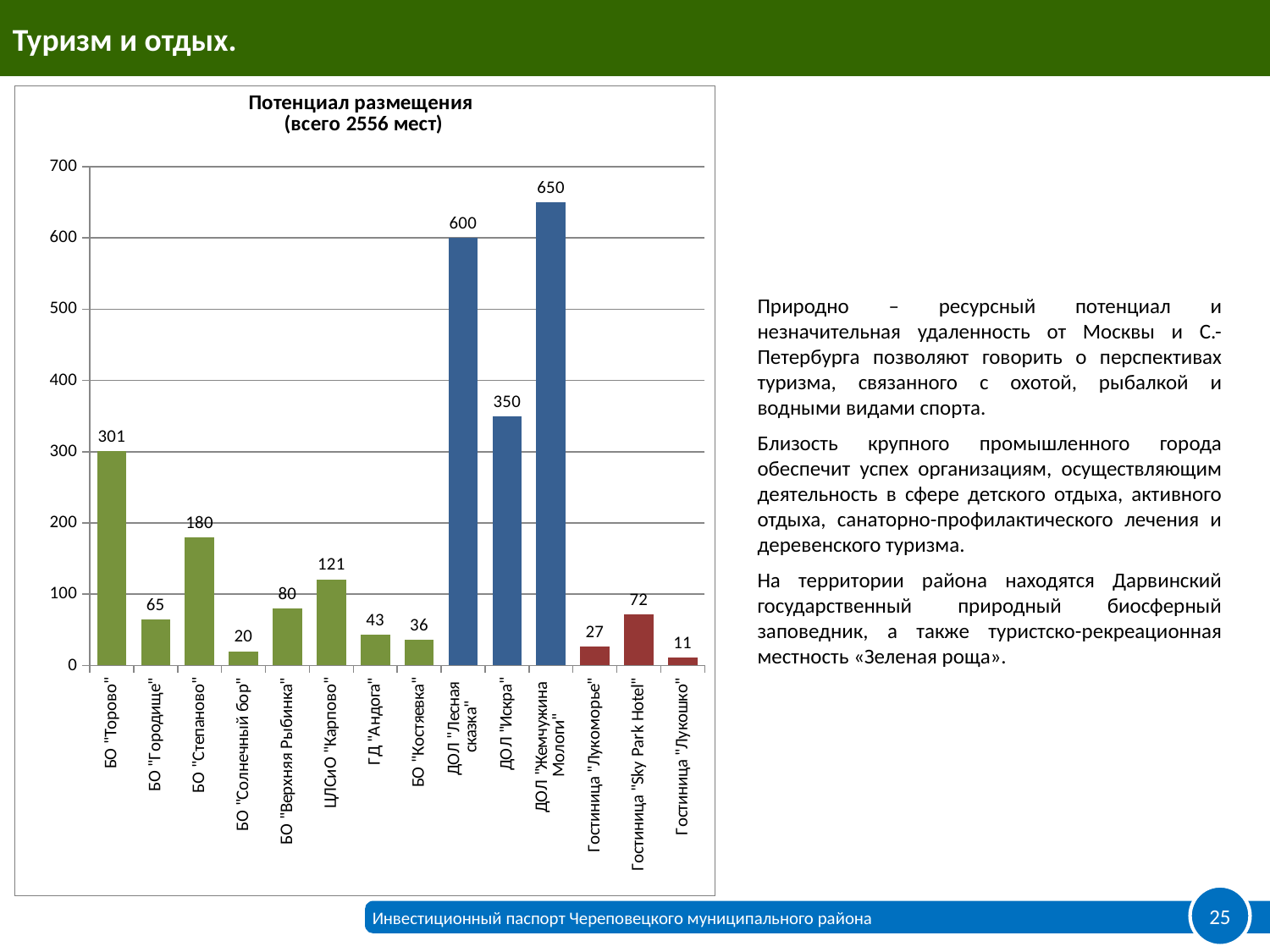
What is the value for БО "Торово"? 301 What total number of places is stated in the chart title? 2556 What is the difference between the values for ДОЛ "Лесная сказка" and ДОЛ "Искра"? 250 What is the value for ДОЛ "Жемчужина Мологи"? 650 What is the difference between the values for БО "Степаново" and ЦЛСиО "Карпово"? 59 Which category has the highest value? ДОЛ "Жемчужина Мологи" Which is larger, the value for БО "Верхняя Рыбинка" or the value for Гостиница "Sky Park Hotel"? БО "Верхняя Рыбинка" Is the value for ДОЛ "Искра" greater or less than 400? less What is the value for Гостиница "Sky Park Hotel"? 72 Which category has the lowest value? Гостиница "Лукошко" What kind of chart is shown on the slide? bar chart How many categories are shown on the x axis? 14